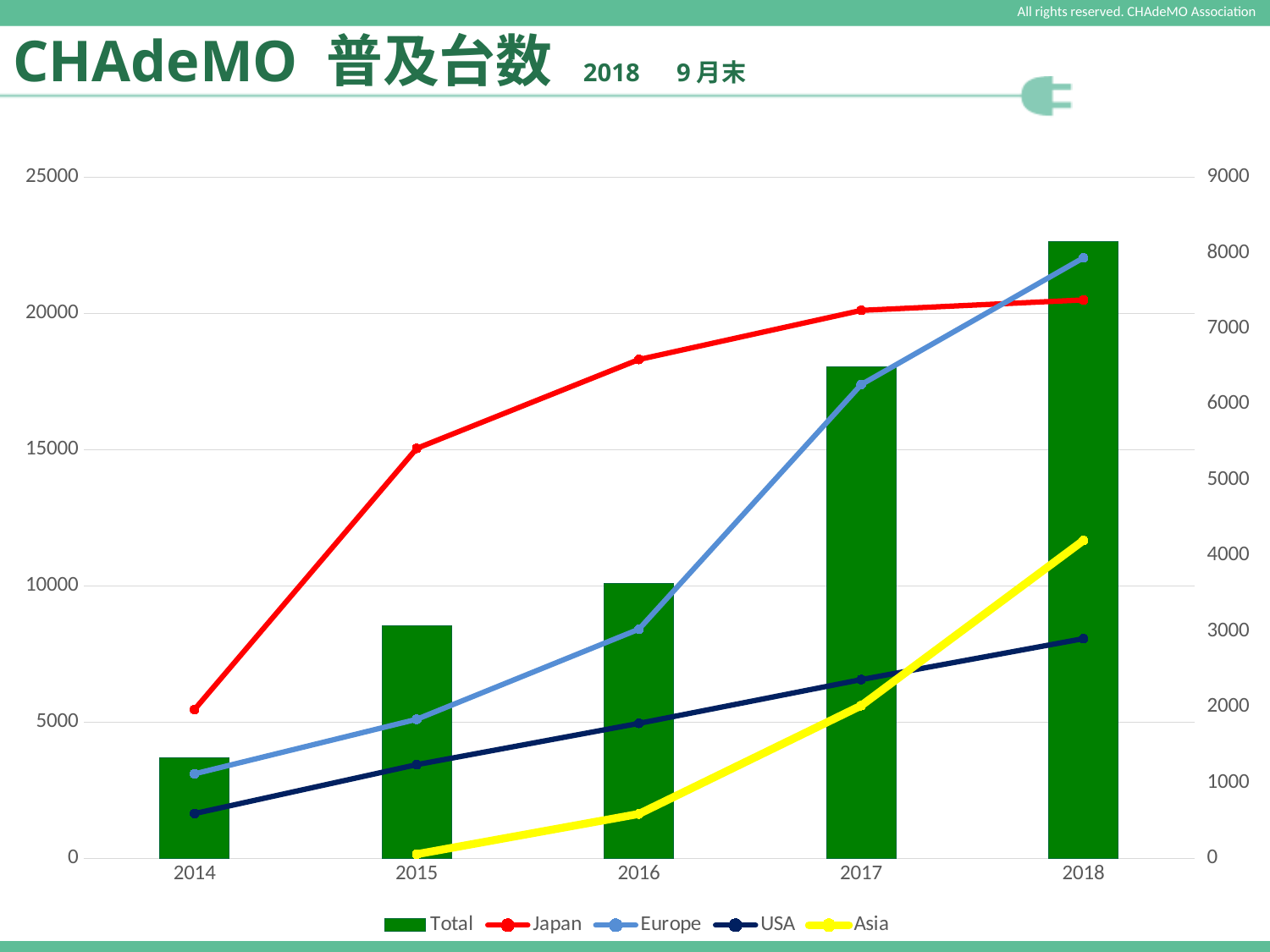
Is the Total value for 2018 greater or less than 20000? greater In which year is the Total bar lowest? 2014 Is the Asia value for 2015 greater or less than 1000 on the right axis? less In which year is the Total bar highest? 2018 How many series does the legend list? 5 Do the Total values rise or fall from 2014 to 2018? Rise Is the Japan value for 2018 greater or less than 7000 on the right axis? greater In 2018, which is higher, the Europe line or the Japan line? Europe What kind of chart is shown on the slide? Combination bar and line chart Which series is drawn as green bars? Total How many years are shown on the x axis? 5